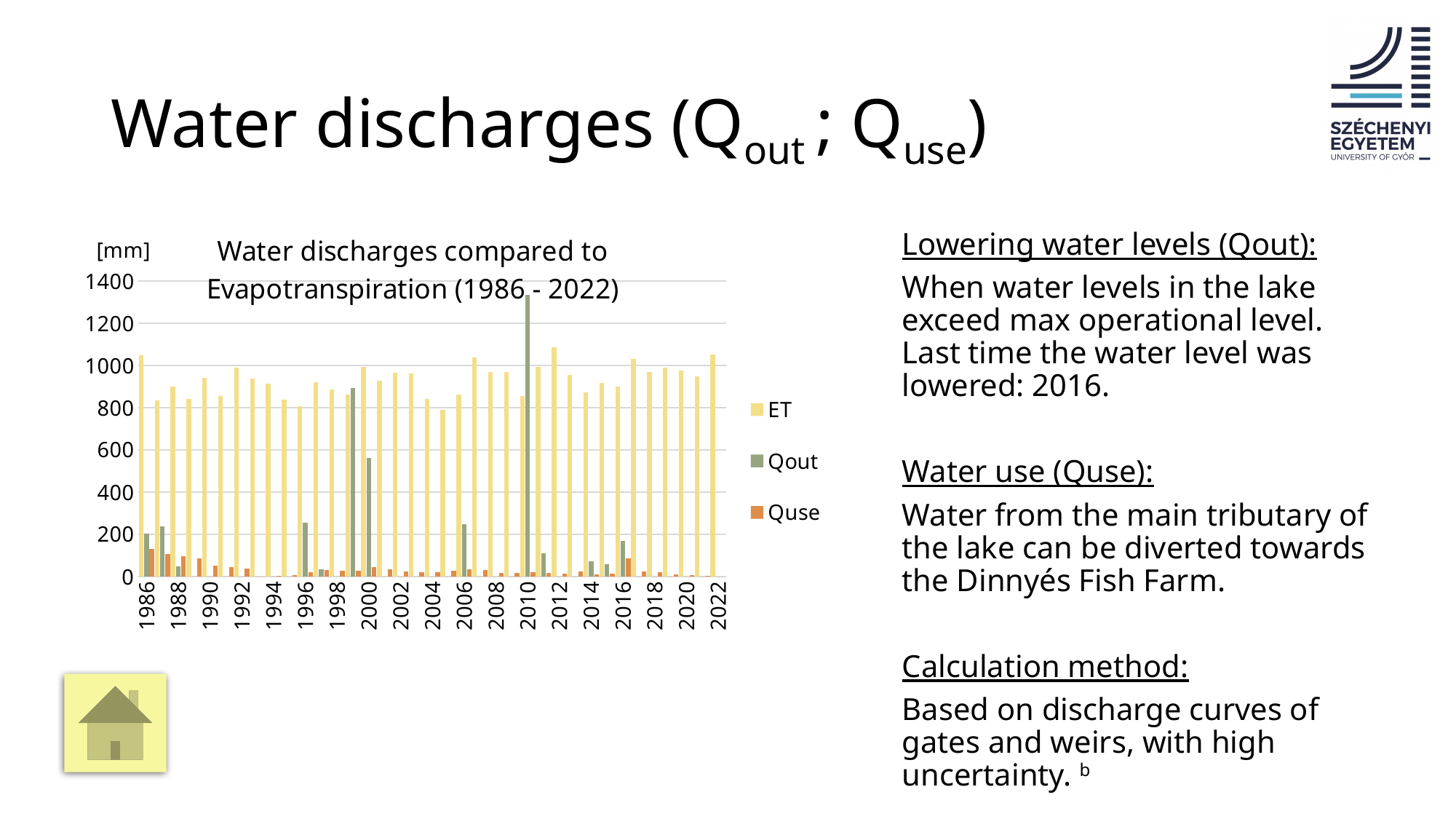
Is the ET value for 1986 greater or less than 1000? greater How many series does the chart legend list? 3 In which year is the Qout value highest? 2010 What kind of chart is shown on the slide? bar chart In 2010, which is larger: the ET value or the Qout value? Qout Is the Qout value for 2010 greater or less than 1200? greater Is the ET value for 2010 greater or less than 1000? less What unit is shown on the chart's vertical axis? [mm] What is the title of the chart? Water discharges compared to Evapotranspiration (1986 - 2022) How many years are covered by the chart? 37 Which is larger: the ET value for 1986 or the ET value for 1987? 1986